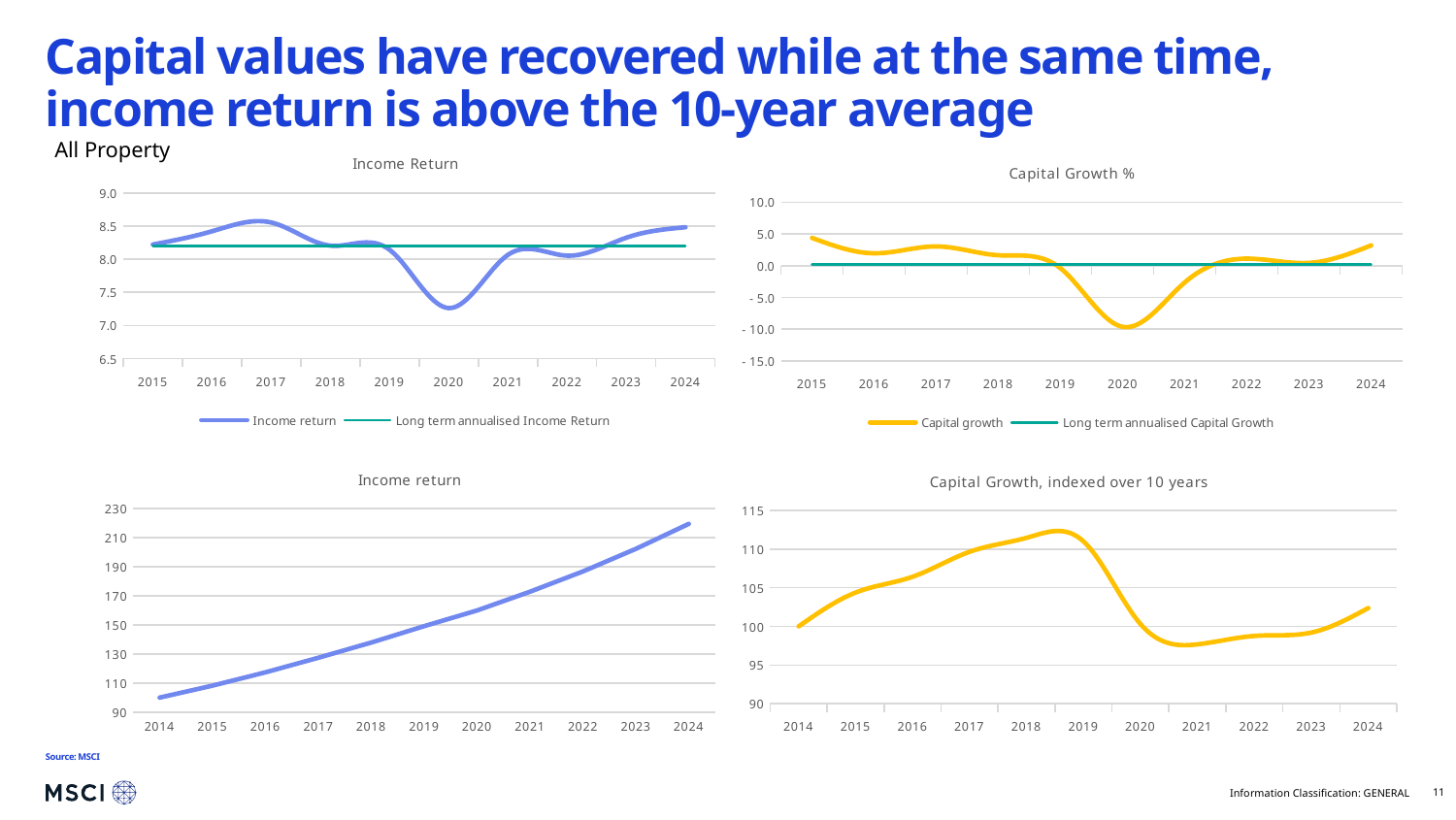
How many years are shown on the x axis of the 'Income return' chart at the bottom left? 11 How many series does the legend of the 'Capital Growth %' chart list? 2 In the 'Income return' chart at the bottom left, is the value for 2024 greater or less than 210? greater In the 'Income return' chart at the bottom left, do the values rise or fall from 2014 to 2024? rise In the 'Capital Growth %' chart, is the capital growth for 2020 greater or less than -5.0? less What kind of chart is the 'Income Return' chart at the top left of the slide? line chart In the 'Income Return' chart at the top left, which year has the lowest income return? 2020 In the 'Capital Growth %' chart, which year has the lowest capital growth? 2020 In the 'Income Return' chart at the top left, is the income return for 2020 greater or less than 7.5? less In the 'Income Return' chart at the top left, which year has the higher income return, 2017 or 2020? 2017 What is the second legend entry in the 'Capital Growth %' chart? Long term annualised Capital Growth In the 'Capital Growth, indexed over 10 years' chart, what is the value for 2014? 100